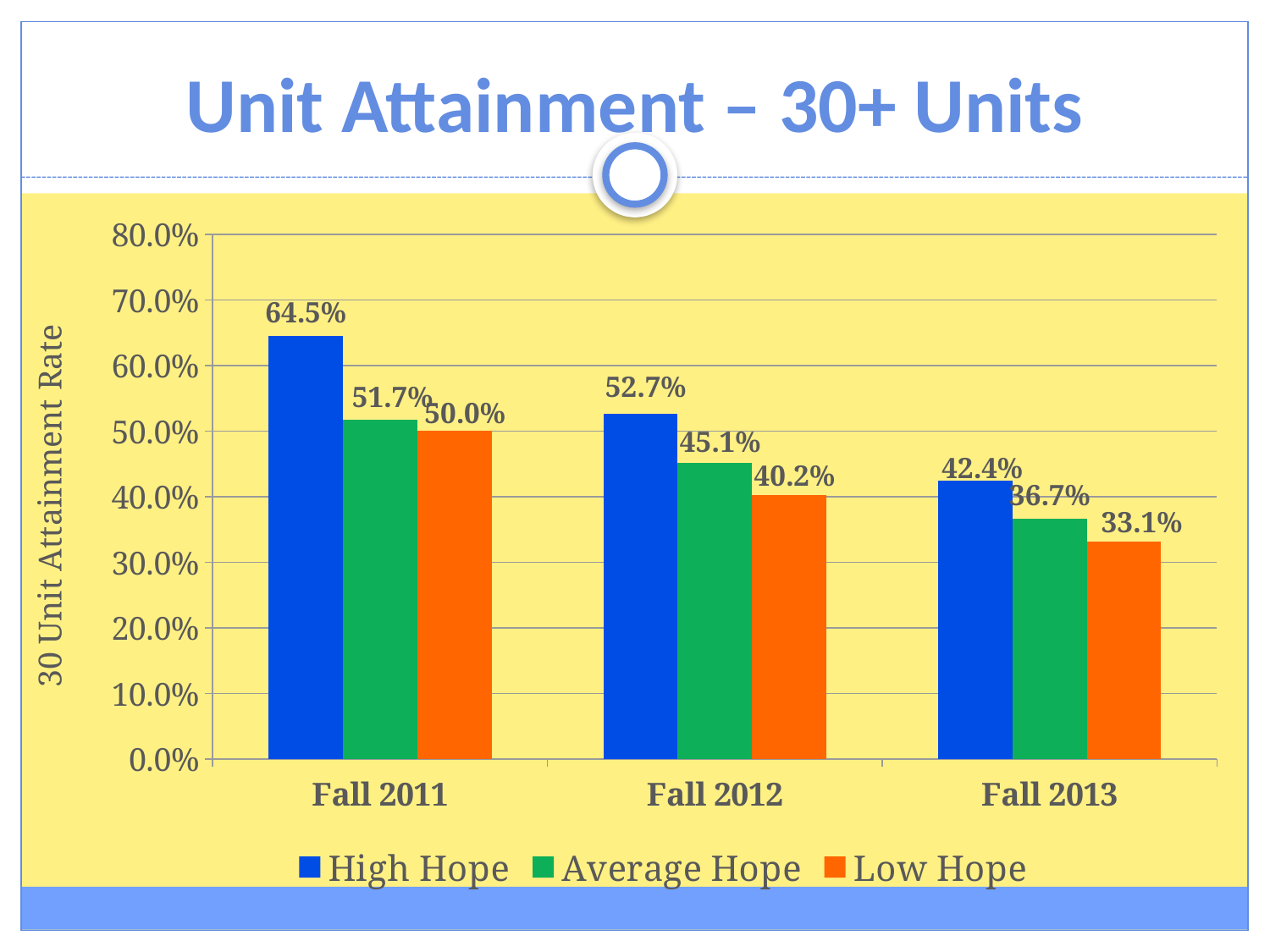
What is the difference between the High Hope and Low Hope attainment rates in Fall 2011? 14.5% Which is larger: the Average Hope rate in Fall 2011 or the High Hope rate in Fall 2012? High Hope rate in Fall 2012 Is the Low Hope attainment rate in Fall 2012 greater or less than 50.0%? less What is the 30 unit attainment rate for High Hope in Fall 2011? 64.5% Which group has the lowest attainment rate in Fall 2013? Low Hope Does the High Hope attainment rate rise or fall from Fall 2011 to Fall 2013? fall How many series does the legend list? 3 What is the 30 unit attainment rate for Low Hope in Fall 2013? 33.1% What is the 30 unit attainment rate for Average Hope in Fall 2012? 45.1% Which term has the highest High Hope attainment rate? Fall 2011 What kind of chart is shown on the slide? bar chart How many terms are shown on the x axis? 3